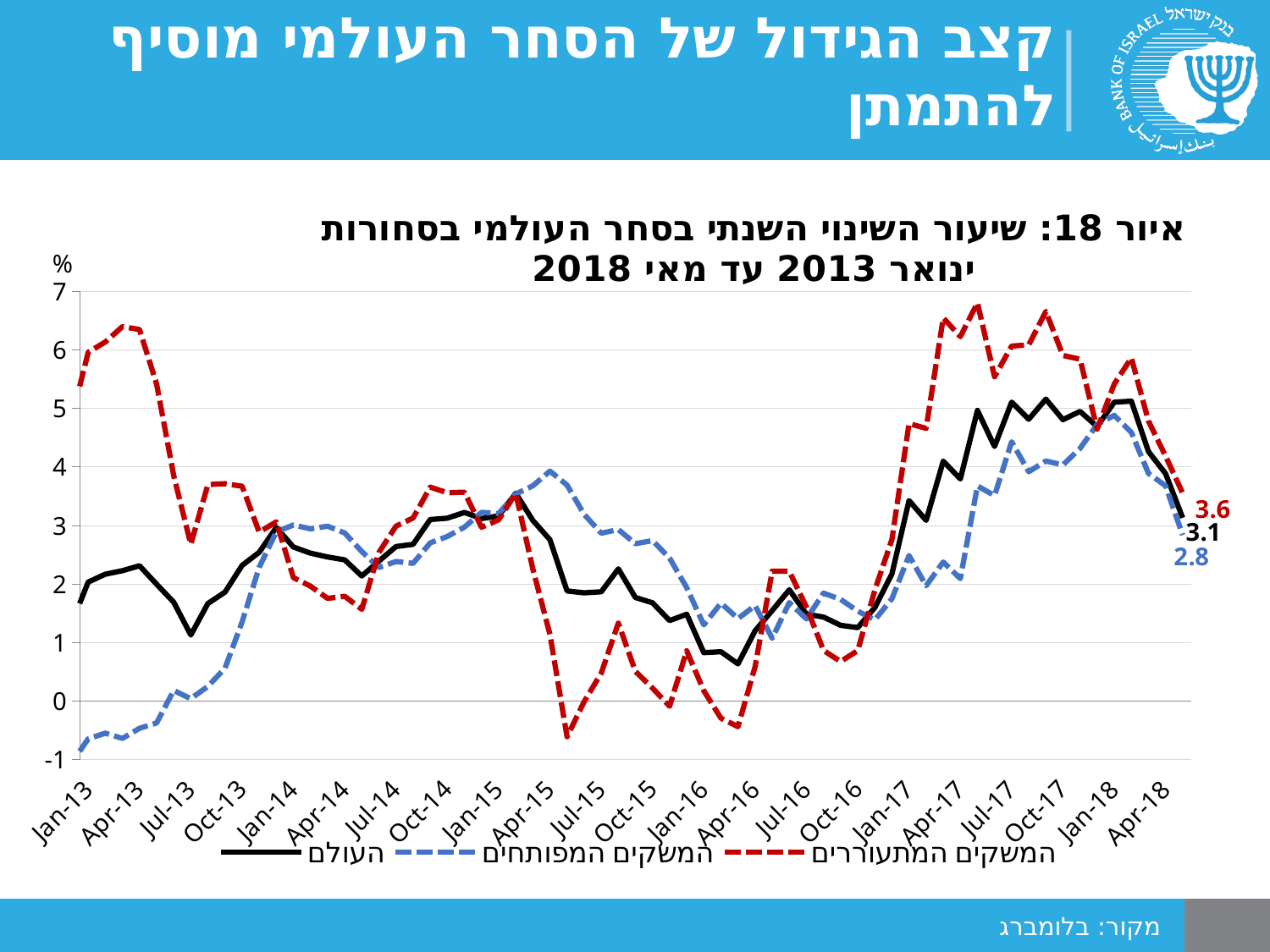
What is the final labelled value for the העולם series? 3.1 What type of chart is shown on the slide? line chart Is the value for המשקים המפותחים at Jan-13 greater or less than 0? less What unit is shown on the vertical axis? % What is the final labelled value for the המשקים המפותחים series? 2.8 Which series has the highest final labelled value? המשקים המתעוררים Which series has the lowest final labelled value? המשקים המפותחים What is the difference between the final labelled values of המשקים המתעוררים and המשקים המפותחים? 0.8 Is the final labelled value for העולם larger or smaller than the final labelled value for המשקים המפותחים? larger Is the value for המשקים המתעוררים at Jan-13 greater or less than 5? greater How many series does the legend list? 3 What is the final labelled value for the המשקים המתעוררים series? 3.6